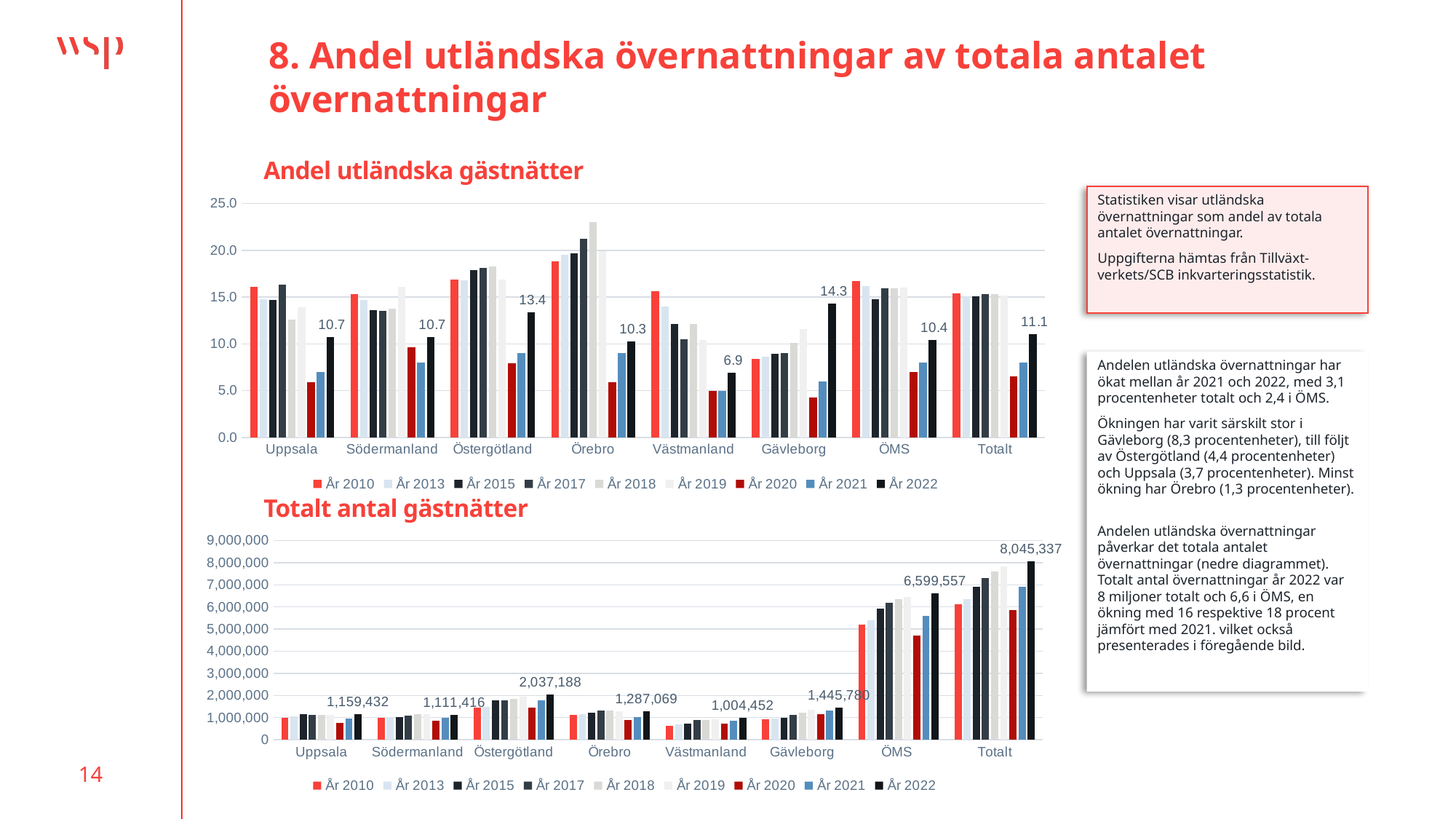
In the 'Totalt antal gästnätter' chart, what is the value for Totalt in År 2022? 8,045,337 In the 'Andel utländska gästnätter' chart, what is the value for Gävleborg in År 2022? 14.3 How many series does the legend of the 'Totalt antal gästnätter' chart list? 9 What kind of chart is the 'Totalt antal gästnätter' chart? Bar chart In the 'Totalt antal gästnätter' chart, what is the value for ÖMS in År 2022? 6,599,557 In the 'Andel utländska gästnätter' chart, what is the difference between the År 2022 values for Gävleborg and Västmanland? 7.4 How many categories are shown on the x axis of the 'Totalt antal gästnätter' chart? 8 In the 'Andel utländska gästnätter' chart, is the År 2018 value for Örebro greater or less than 20.0? greater In the 'Andel utländska gästnätter' chart, what is the value for Västmanland in År 2022? 6.9 In the 'Totalt antal gästnätter' chart, what is the difference between the År 2022 values for Totalt and ÖMS? 1,445,780 In the 'Andel utländska gästnätter' chart, which category has the lowest labelled År 2022 value? Västmanland In the 'Andel utländska gästnätter' chart, is the År 2022 value for Östergötland greater or less than the År 2022 value for Örebro? greater